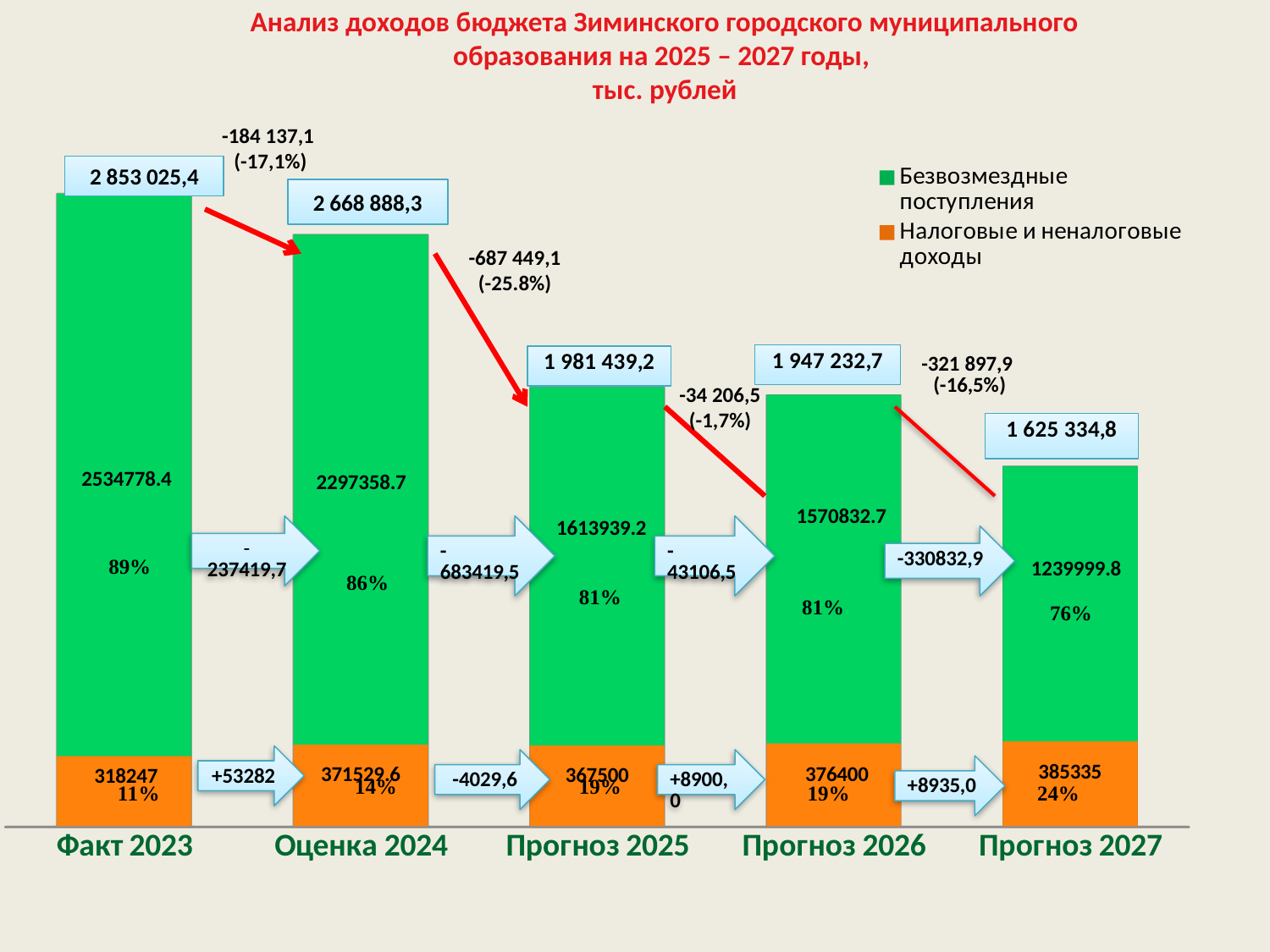
Which is larger: Безвозмездные поступления for Оценка 2024 or for Прогноз 2026? Оценка 2024 Which category has the highest value for Безвозмездные поступления? Факт 2023 How many categories are shown on the x axis? 5 What is the difference between Налоговые и неналоговые доходы for Прогноз 2026 and Прогноз 2025? 8900 What is the total shown for Прогноз 2025? 1 981 439,2 What is the value of Налоговые и неналоговые доходы for Прогноз 2027? 385335 What share of the total does Налоговые и неналоговые доходы make up in Прогноз 2027, as labelled on the bar? 24% What type of chart is shown on the slide? stacked bar chart Do the values of Безвозмездные поступления rise or fall from Факт 2023 to Прогноз 2027? fall How many series does the legend list? 2 What is the value of Безвозмездные поступления for Факт 2023? 2534778.4 Which category has the lowest value for Налоговые и неналоговые доходы? Факт 2023